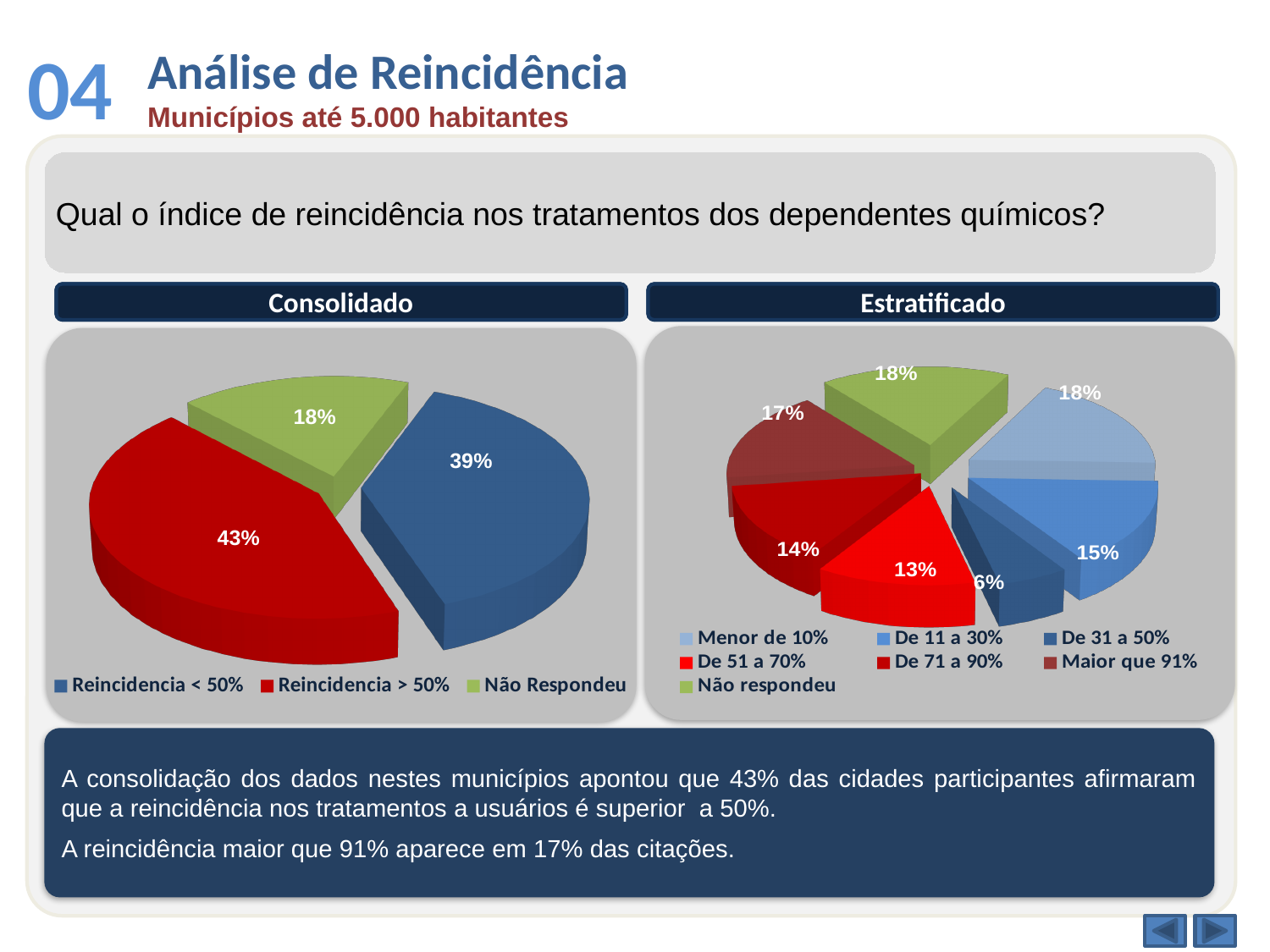
In the Consolidado chart, what is the difference between Reincidencia > 50% and Reincidencia < 50%? 4% In the Estratificado chart, what percentage is shown for Maior que 91%? 17% In the Consolidado chart, what percentage is shown for Reincidencia > 50%? 43% In the Estratificado chart, which is larger: De 11 a 30% or De 51 a 70%? De 11 a 30% In the Estratificado chart, what is the difference between De 71 a 90% and De 51 a 70%? 1% In the Consolidado chart, which category has the largest slice? Reincidencia > 50% In the Estratificado chart, which category has the smallest slice? De 31 a 50% In the Consolidado chart, what percentage is shown for Não Respondeu? 18% How many categories does the legend of the Estratificado chart list? 7 What kind of chart is the Consolidado chart? Pie chart In the Consolidado chart, what percentage is shown for Reincidencia < 50%? 39% In the Estratificado chart, what percentage is shown for De 31 a 50%? 6%